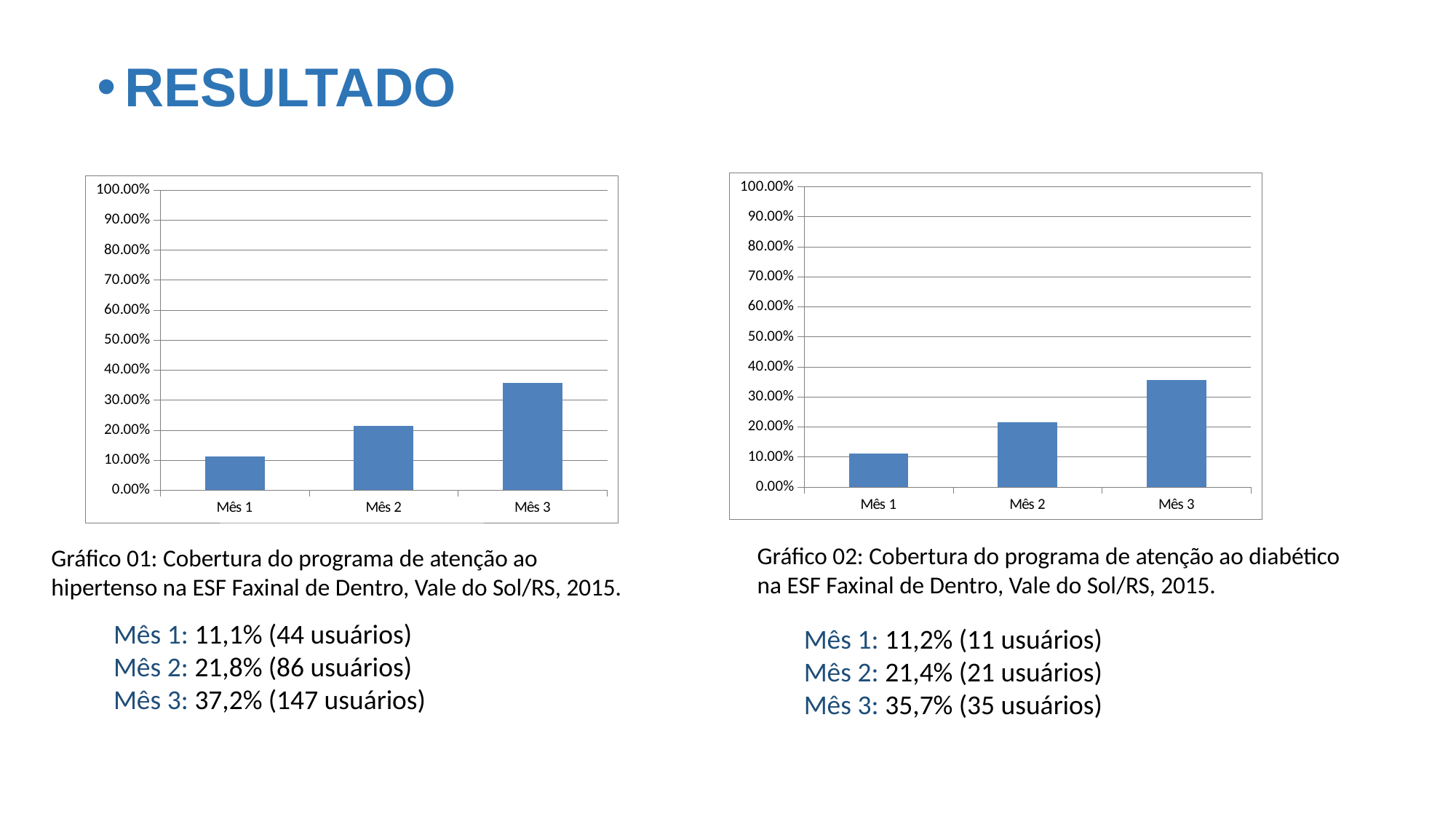
According to the slide text, what is the coverage for Mês 2 in Gráfico 01 (the left chart)? 21,8% In Gráfico 02 (the right chart), which month has the lowest bar? Mês 1 In Gráfico 02 (the right chart), is the value for Mês 2 greater or less than 30.00%? less In Gráfico 01 (the left chart), which month has the highest bar? Mês 3 Do the values in Gráfico 02 (the right chart) rise or fall from Mês 1 to Mês 3? rise How many categories are shown on the x axis of Gráfico 02 (the right chart)? 3 In Gráfico 02 (the right chart), is the value for Mês 1 greater or less than 20.00%? less What is the maximum value shown on the y axis of Gráfico 01 (the left chart)? 100.00% What kind of chart is Gráfico 01 (the left chart)? bar chart According to the slide text, what is the coverage for Mês 1 in Gráfico 02 (the right chart)? 11,2% In Gráfico 01 (the left chart), is the value for Mês 3 greater or less than 30.00%? greater In Gráfico 01 (the left chart), which is larger, the value for Mês 1 or the value for Mês 2? Mês 2